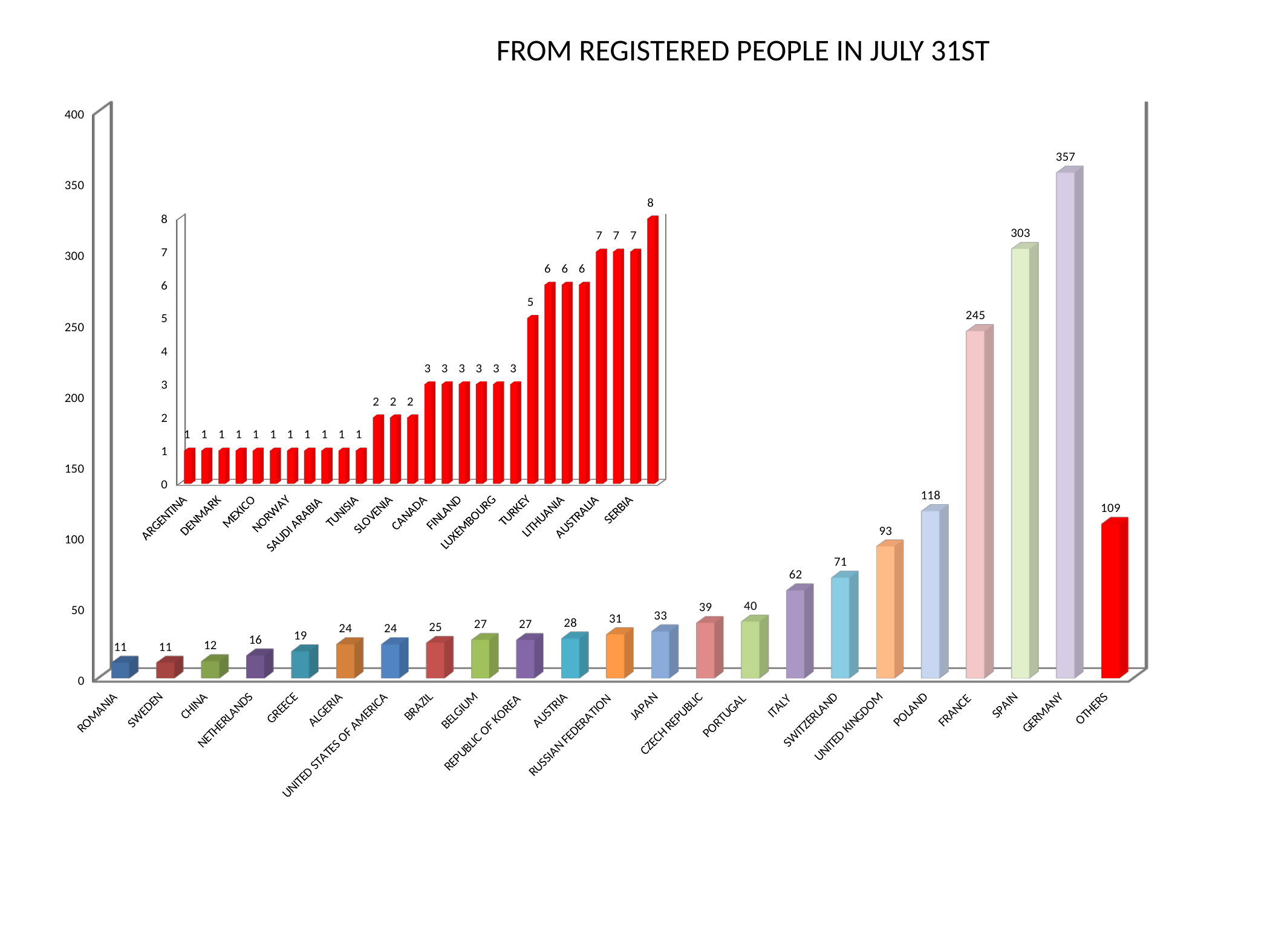
On the inset chart in the upper left, what is the lowest value shown? 1 On the main chart, what is the value for Germany? 357 On the main chart, do the values generally rise or fall from Romania to Germany along the x axis? Rise On the inset chart in the upper left, what is the highest value shown? 8 On the main chart, what is the difference between the values for Spain and France? 58 What kind of chart is the main chart on the slide? Bar chart On the main chart, which country has the highest value? Germany On the main chart, how many bars are plotted? 23 On the main chart, what is the value for Japan? 33 On the main chart, which is larger, the value for United Kingdom or the value for Others? Others On the main chart, what is the value for Poland? 118 What is the title of the main chart? FROM REGISTERED PEOPLE IN JULY 31ST